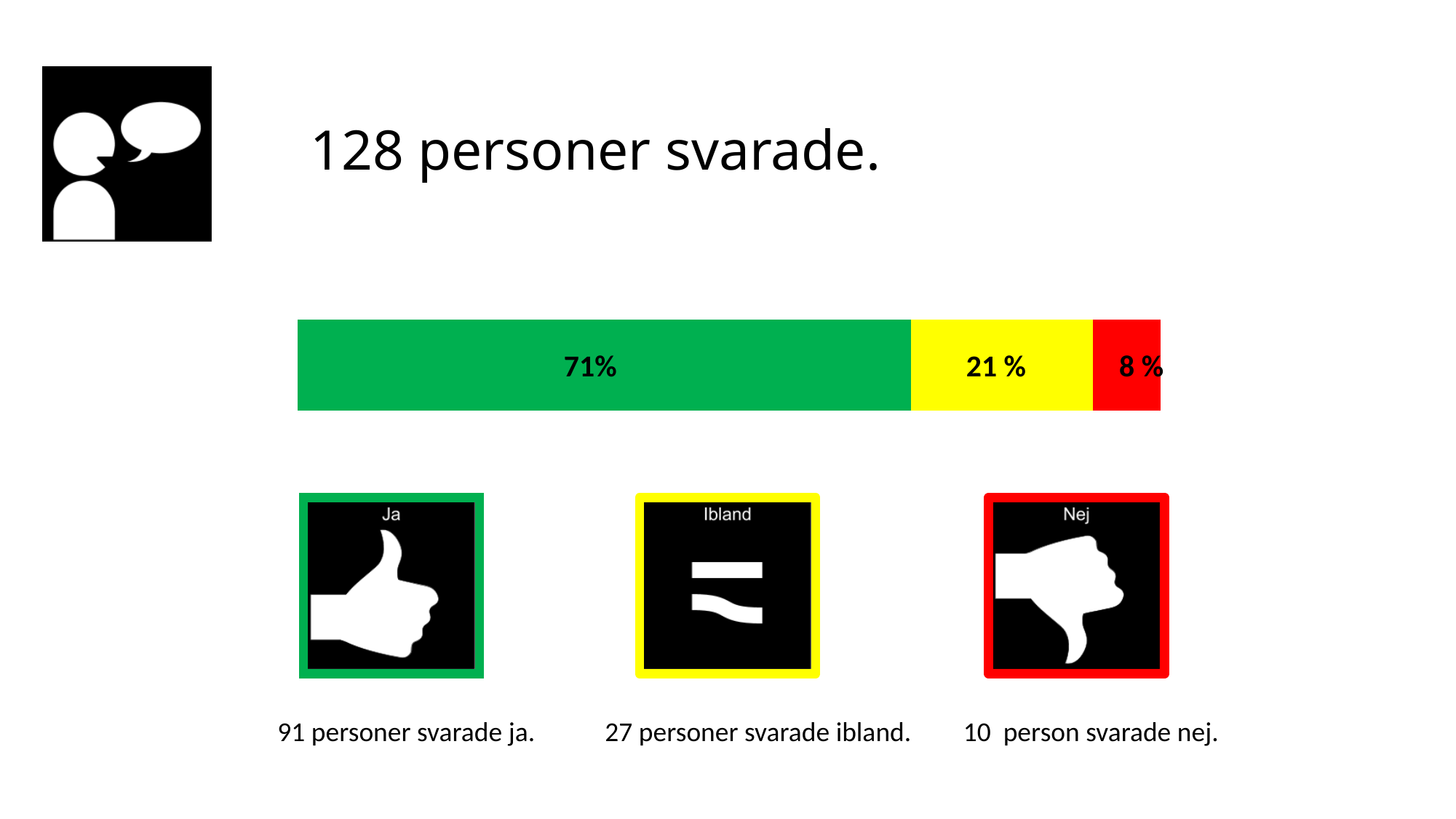
What percentage is shown on the yellow 'Ibland' segment of the bar? 21 % What percentage of the bar is labelled for the green 'Ja' segment? 71% What is the difference in percentage points between the 'Ja' segment and the 'Ibland' segment? 50 percentage points Which segment is larger, 'Ibland' or 'Nej'? Ibland How many people answered 'ja' according to the slide? 91 How many people in total responded, according to the slide title? 128 How many segments does the stacked bar contain? 3 Which response category has the largest share of the bar? Ja Which response category has the smallest share of the bar? Nej What percentage is shown on the red 'Nej' segment of the bar? 8 % What colour is the segment representing 'Nej'? Red What kind of chart is shown on the slide? Stacked horizontal bar chart